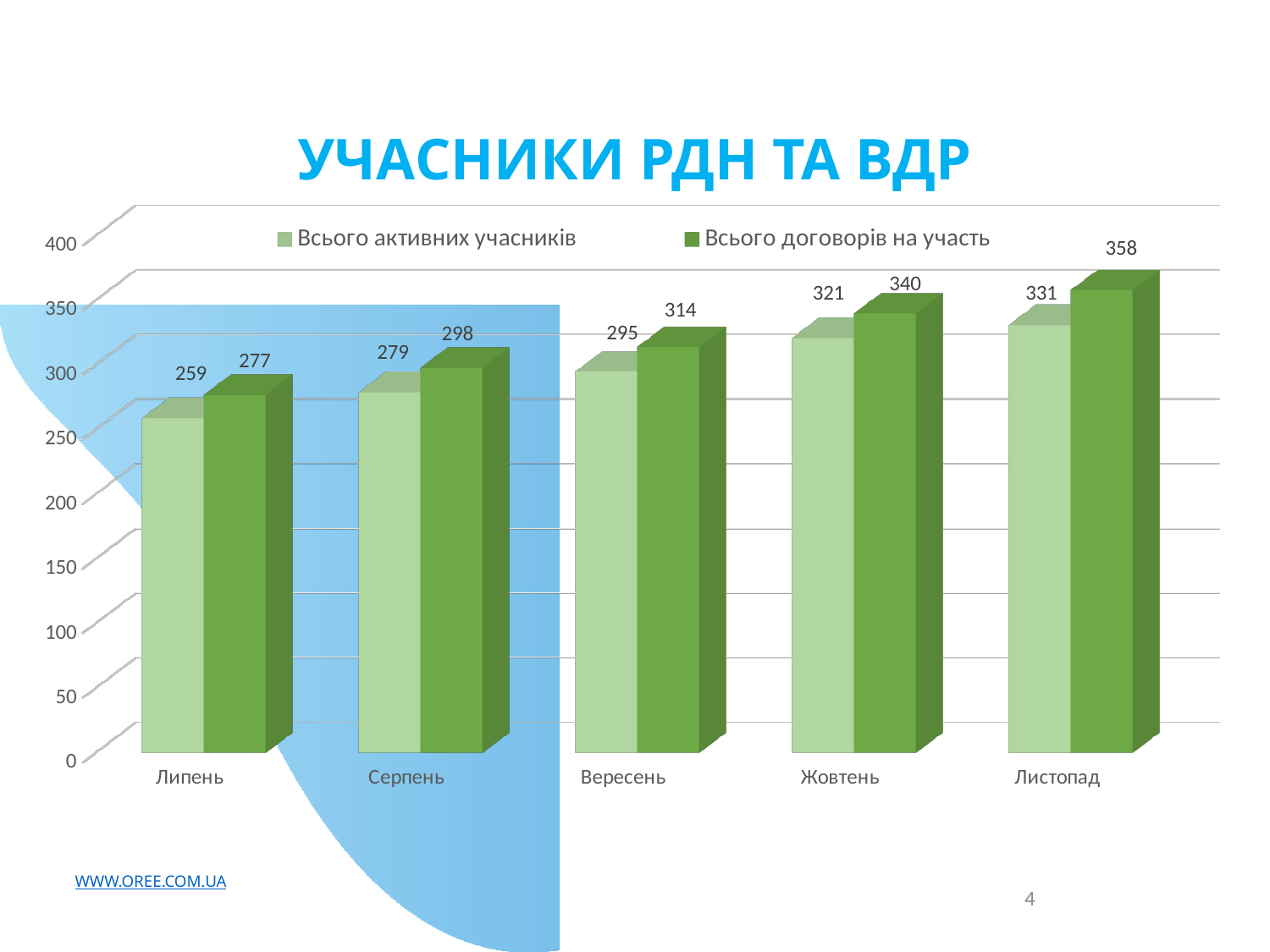
Which month has the highest value for 'Всього активних учасників'? Листопад How many series does the legend list? 2 How many months are shown on the x axis? 5 What is the difference between 'Всього договорів на участь' and 'Всього активних учасників' for Жовтень? 19 What is the value of 'Всього договорів на участь' for Листопад? 358 What is the value of 'Всього договорів на участь' for Вересень? 314 Which is larger: 'Всього активних учасників' for Серпень or 'Всього активних учасників' for Вересень? Вересень Which month has the lowest value for 'Всього договорів на участь'? Липень What is the value of 'Всього активних учасників' for Липень? 259 What is the title of the chart? УЧАСНИКИ РДН ТА ВДР Do the values for 'Всього договорів на участь' rise or fall from Липень to Листопад? Rise What kind of chart is shown on the slide? Bar chart